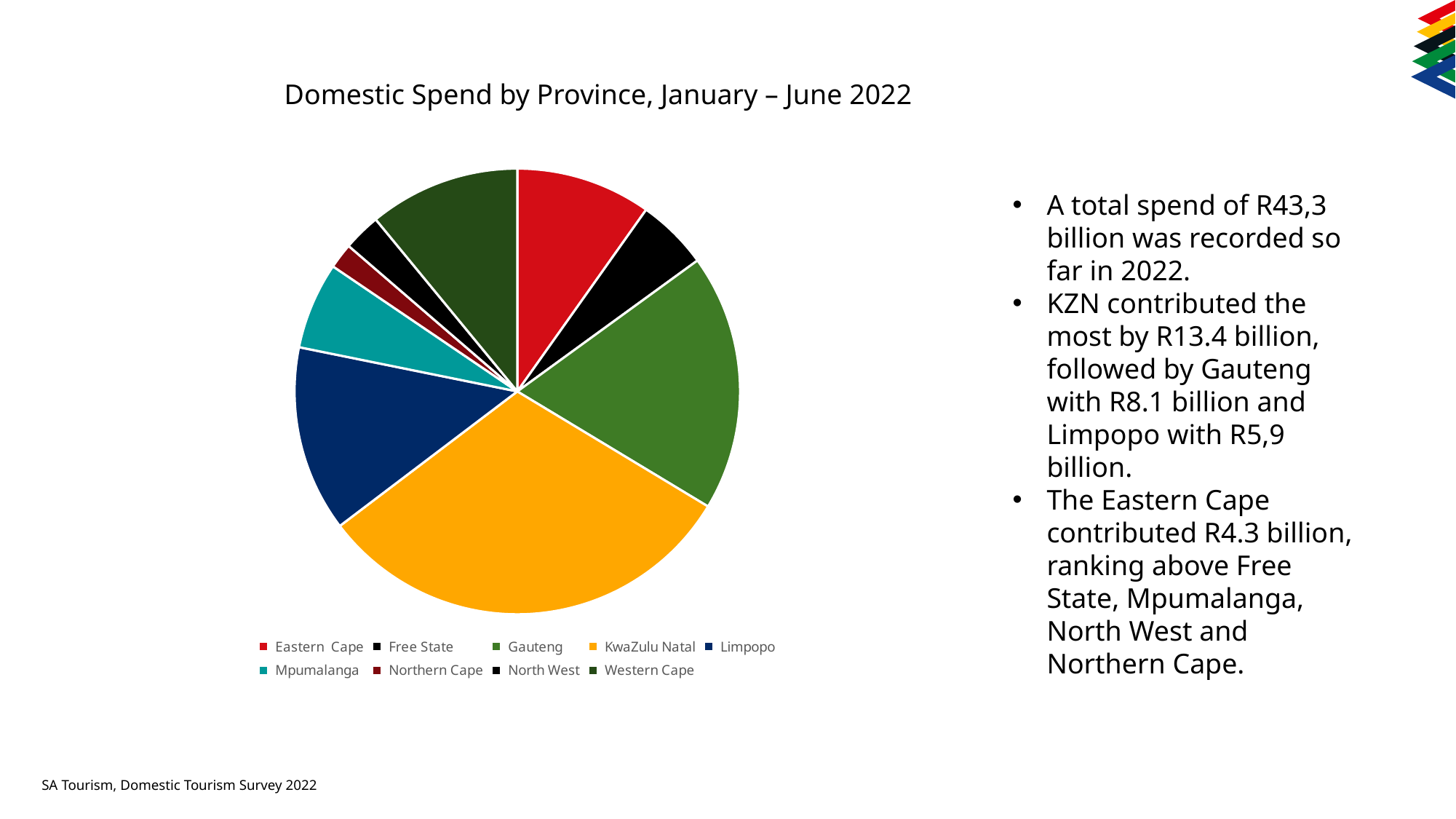
Which slice is larger, Limpopo or Western Cape? Limpopo Which slice is larger, Western Cape or Mpumalanga? Western Cape What is the title of the chart? Domestic Spend by Province, January – June 2022 What kind of chart is shown on the slide? Pie chart Which slice is larger, Gauteng or Limpopo? Gauteng According to the slide, how much did KZN contribute to domestic spend? R13.4 billion How many provinces are shown as slices in the pie chart? 9 Which province has the largest slice of the pie chart? KwaZulu Natal What colour is the KwaZulu Natal slice in the pie chart? Orange According to the slide, how much did Gauteng contribute to domestic spend? R8.1 billion Which province has the smallest slice of the pie chart? Northern Cape